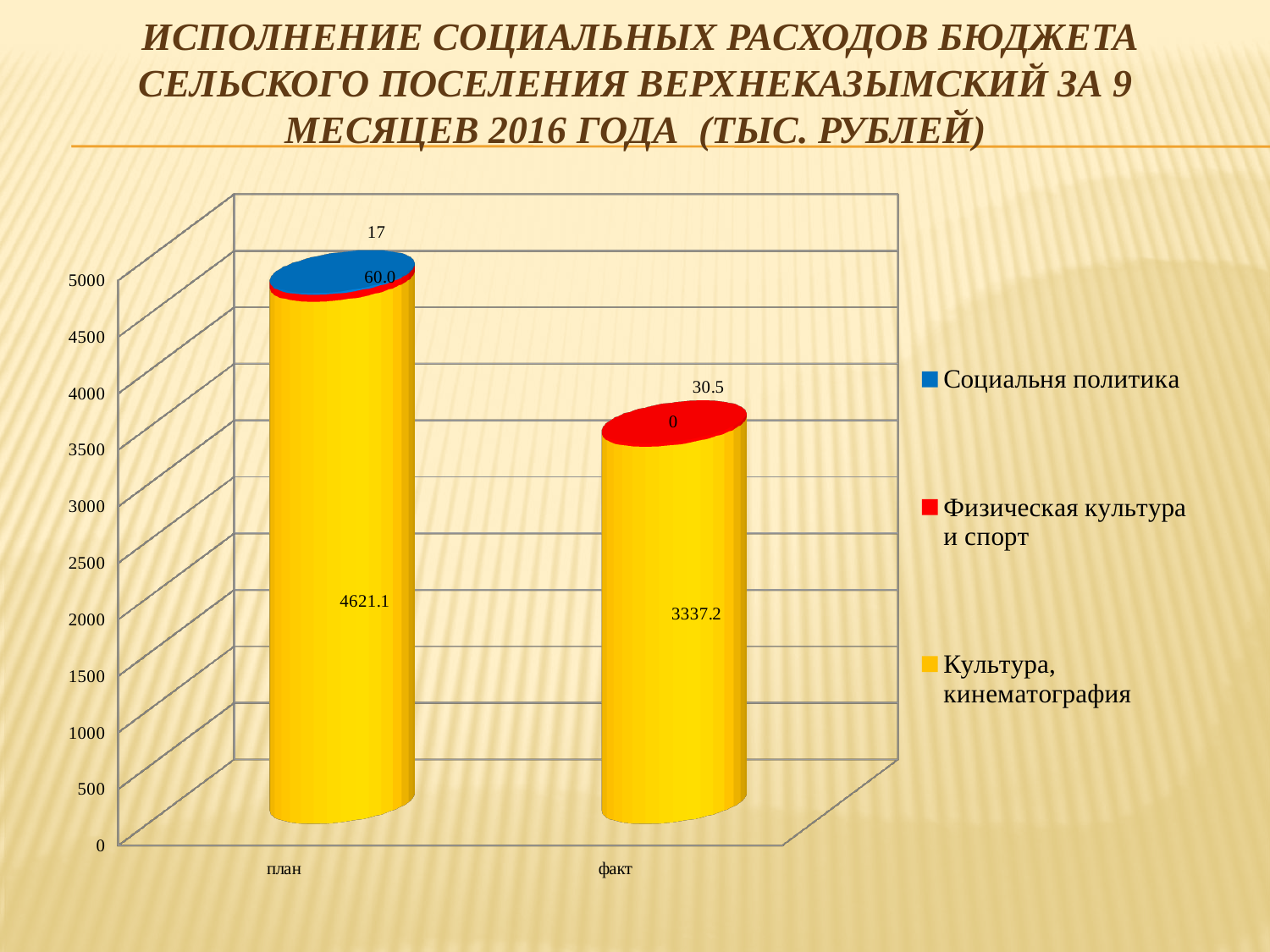
What kind of chart is shown on the slide? Stacked bar chart What is the value of Культура, кинематография for план? 4621.1 What is the total of the stacked bar for план? 4698.1 What is the value of Физическая культура и спорт for план? 60.0 What is the value of Социальня политика for план? 17 What is the value of Физическая культура и спорт for факт? 30.5 How many series does the legend list? 3 What is the difference between the план and факт values for Культура, кинематография? 1283.9 Which category has the higher value for Культура, кинематография, план or факт? план What is the value of Культура, кинематография for факт? 3337.2 What is the total of the stacked bar for факт? 3367.7 What is the value of Социальня политика for факт? 0